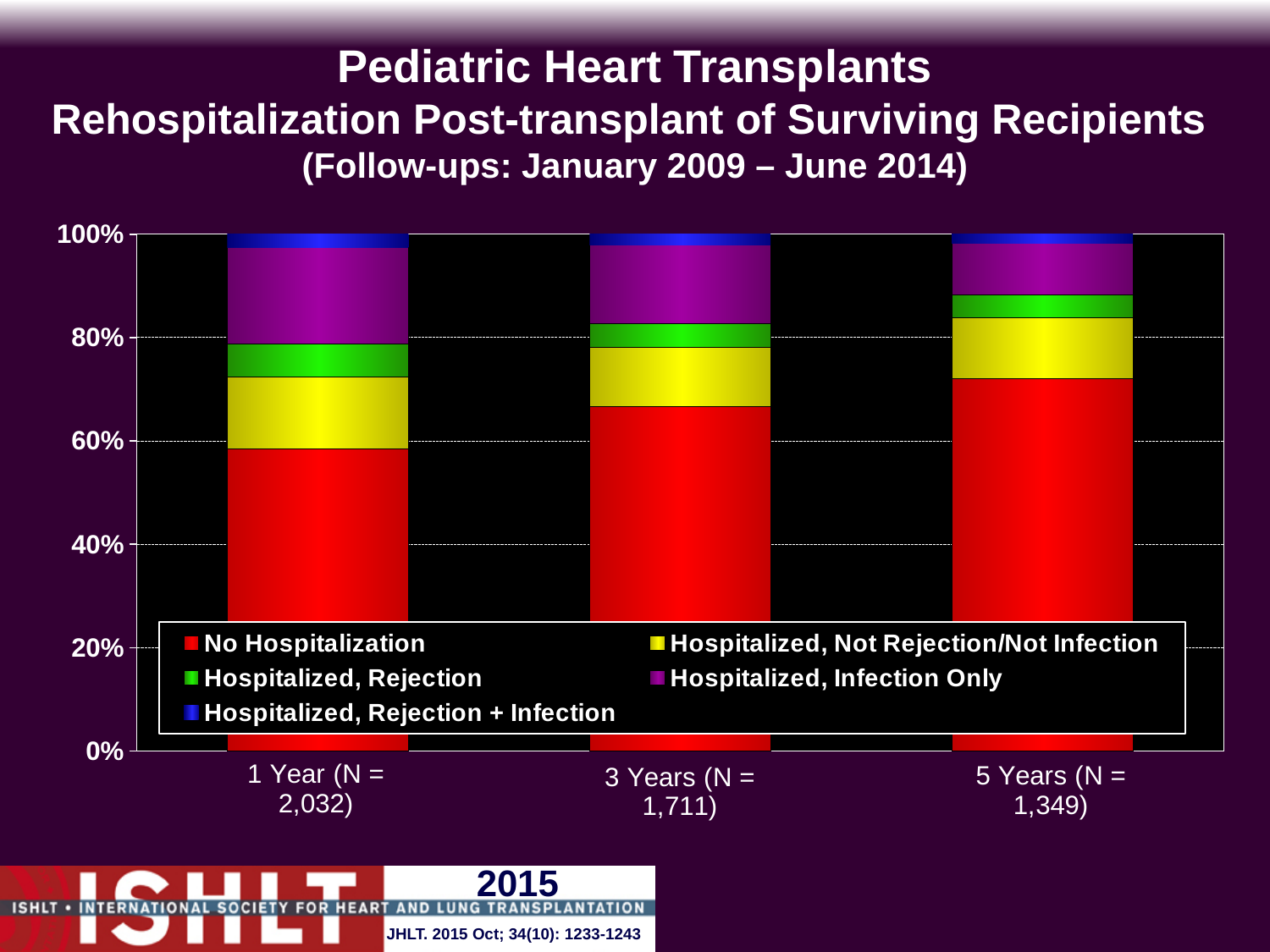
Which follow-up time point has the lowest No Hospitalization share? 1 Year (N = 2,032) Is the No Hospitalization share for 5 Years (N = 1,349) greater or less than 60%? greater Which has the larger Hospitalized, Infection Only share: 1 Year (N = 2,032) or 5 Years (N = 1,349)? 1 Year (N = 2,032) Which follow-up time point has the highest No Hospitalization share? 5 Years (N = 1,349) Is the No Hospitalization share for 1 Year (N = 2,032) greater or less than 60%? less What is the total of the stacked bar for 3 Years (N = 1,711)? 100% Which colour represents Hospitalized, Rejection in the legend? green What kind of chart is shown on the slide? stacked bar chart Is the No Hospitalization share for 3 Years (N = 1,711) greater or less than 80%? less Does the No Hospitalization share rise or fall from 1 Year to 5 Years? rise How many series does the legend list? 5 How many follow-up time points (categories) are shown on the x axis? 3